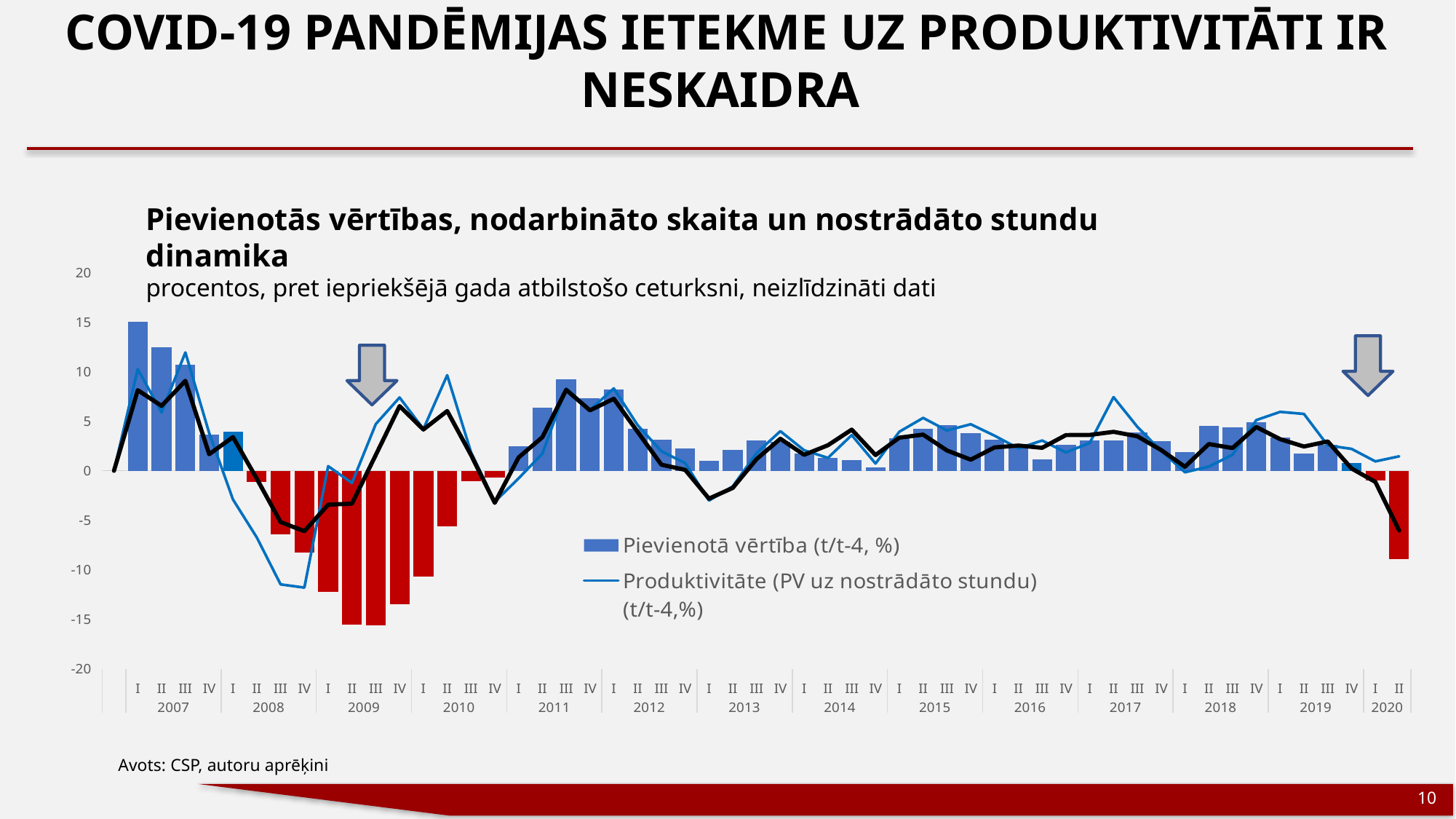
How many series does the chart legend list? 2 Which has the larger Pievienotā vērtība value, 2007 I or 2011 III? 2007 I In which quarter is the Pievienotā vērtība bar the highest? 2007 I Is the series Pievienotā vērtība (t/t-4, %) plotted as bars or as a line? bars In which year are the lowest Pievienotā vērtība bars found? 2009 Is the Pievienotā vērtība value for 2020 II greater or less than -5? less What is the title of the chart? Pievienotās vērtības, nodarbināto skaita un nostrādāto stundu dinamika What source is cited below the chart? Avots: CSP, autoru aprēķini Is the Pievienotā vērtība value for 2009 II greater or less than -10? less Do the Pievienotā vērtība bars rise or fall from 2007 I to 2008 IV? fall Is the Pievienotā vērtība value for 2007 I greater or less than 10? greater How many years are labelled on the x axis? 14